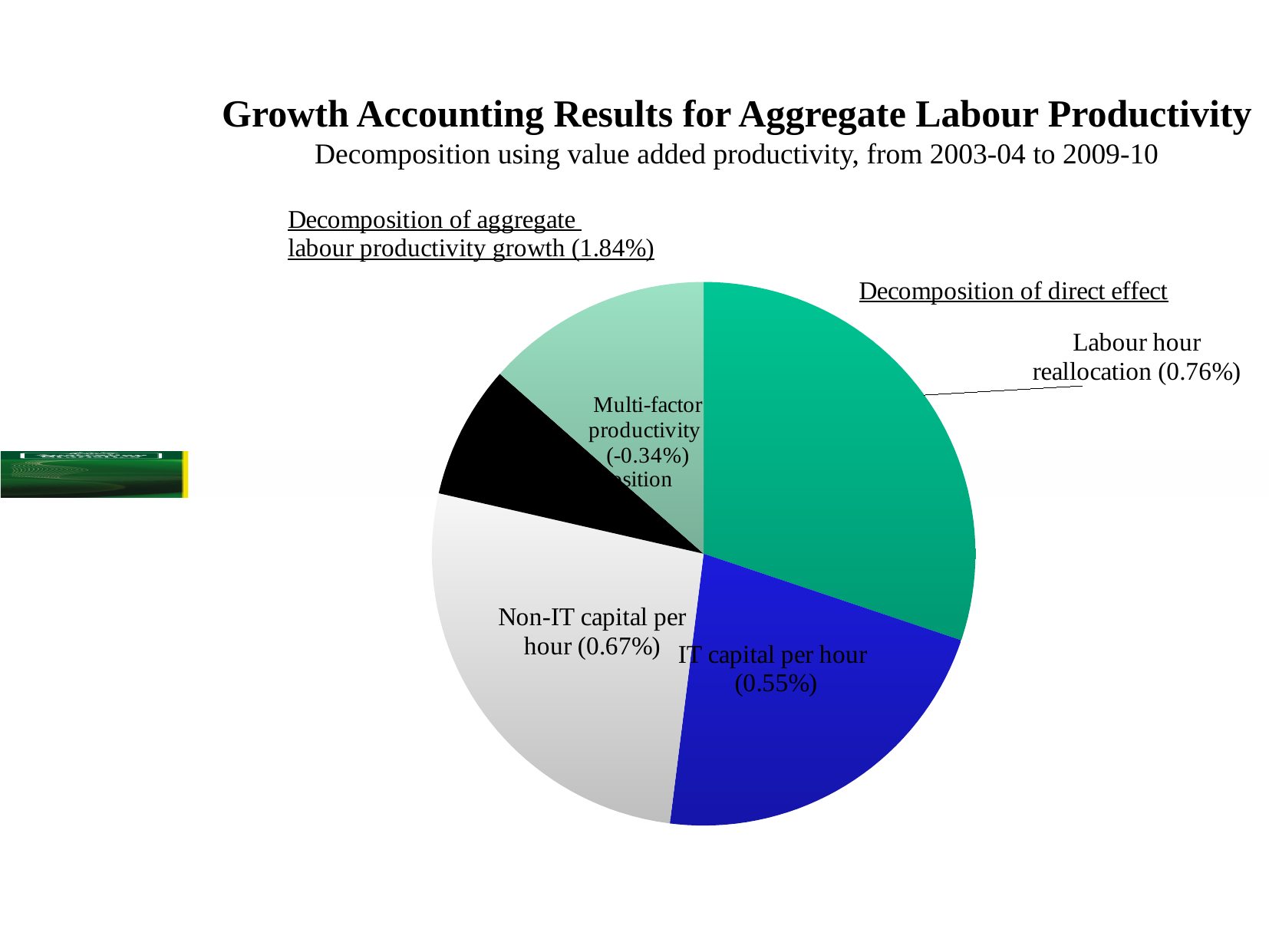
What is the value shown for IT capital per hour? 0.55% What is the value shown for Labour hour reallocation? 0.76% What is the value shown for Non-IT capital per hour? 0.67% What is the value shown for Multi-factor productivity? -0.34% What type of chart is shown on the slide? pie chart What is the aggregate labour productivity growth figure given in the chart's label? 1.84% What is the difference between the values for Labour hour reallocation and IT capital per hour? 0.21 percentage points What period does the decomposition in the chart cover, according to the subtitle? 2003-04 to 2009-10 How many slices does the pie chart have? 5 Which labelled component has the largest value in the pie chart? Labour hour reallocation What is the difference between the values for Non-IT capital per hour and IT capital per hour? 0.12 percentage points Which is larger, Non-IT capital per hour or IT capital per hour? Non-IT capital per hour